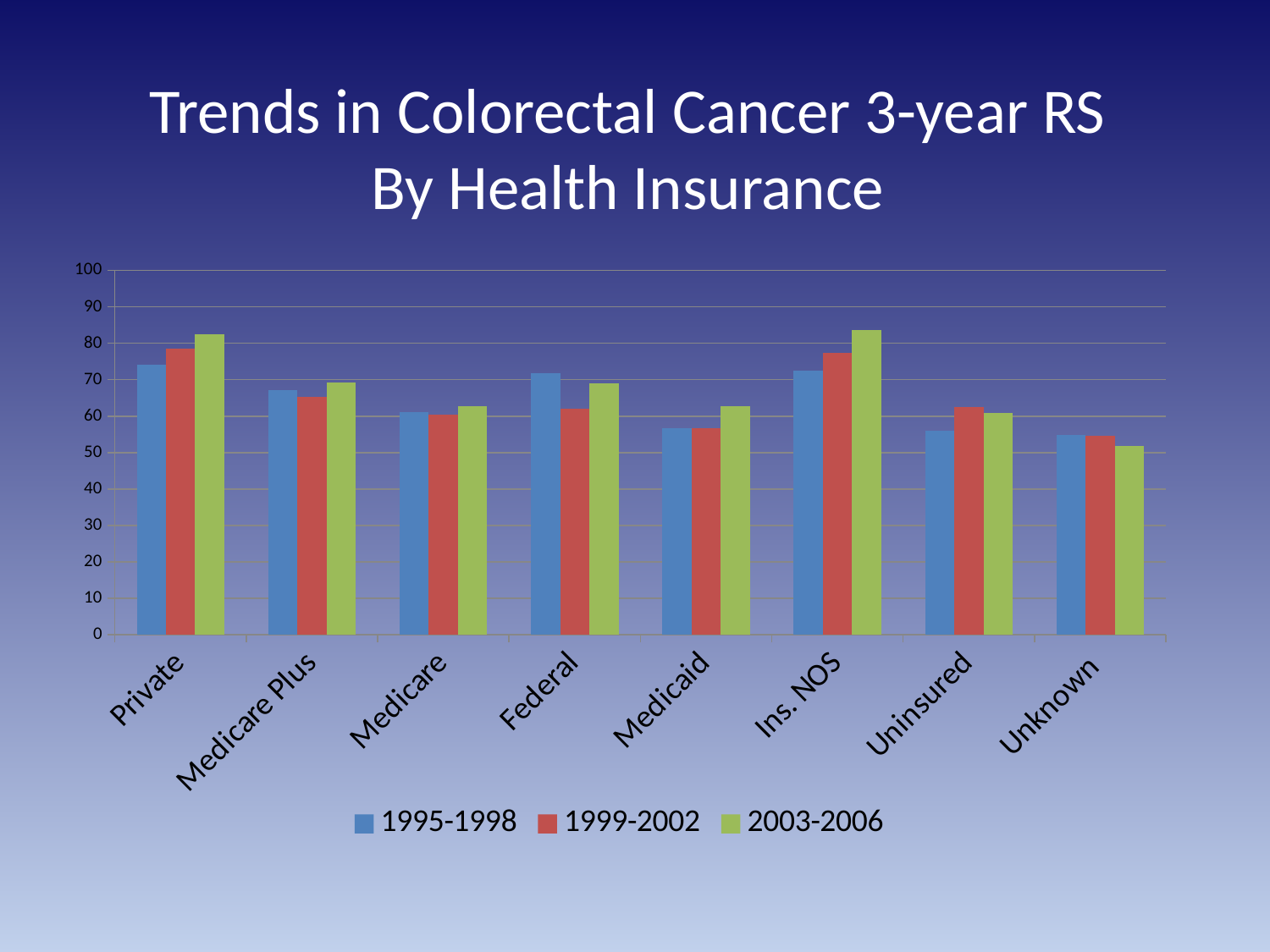
Is the value for Federal in 1995-1998 greater or less than 70? greater What kind of chart is shown on the slide? bar chart For Federal, which series has the larger value: 1995-1998 or 1999-2002? 1995-1998 Which category has the lowest value for the 2003-2006 series? Unknown For the Unknown category, do the values rise or fall from 1995-1998 to 2003-2006? fall Is the value for Unknown in 2003-2006 greater or less than 60? less How many series does the legend list? 3 Is the value for Private in 2003-2006 greater or less than 80? greater For Uninsured, which series has the larger value: 1995-1998 or 1999-2002? 1999-2002 How many health insurance categories are shown on the x axis? 8 What is the title of the chart on the slide? Trends in Colorectal Cancer 3-year RS By Health Insurance